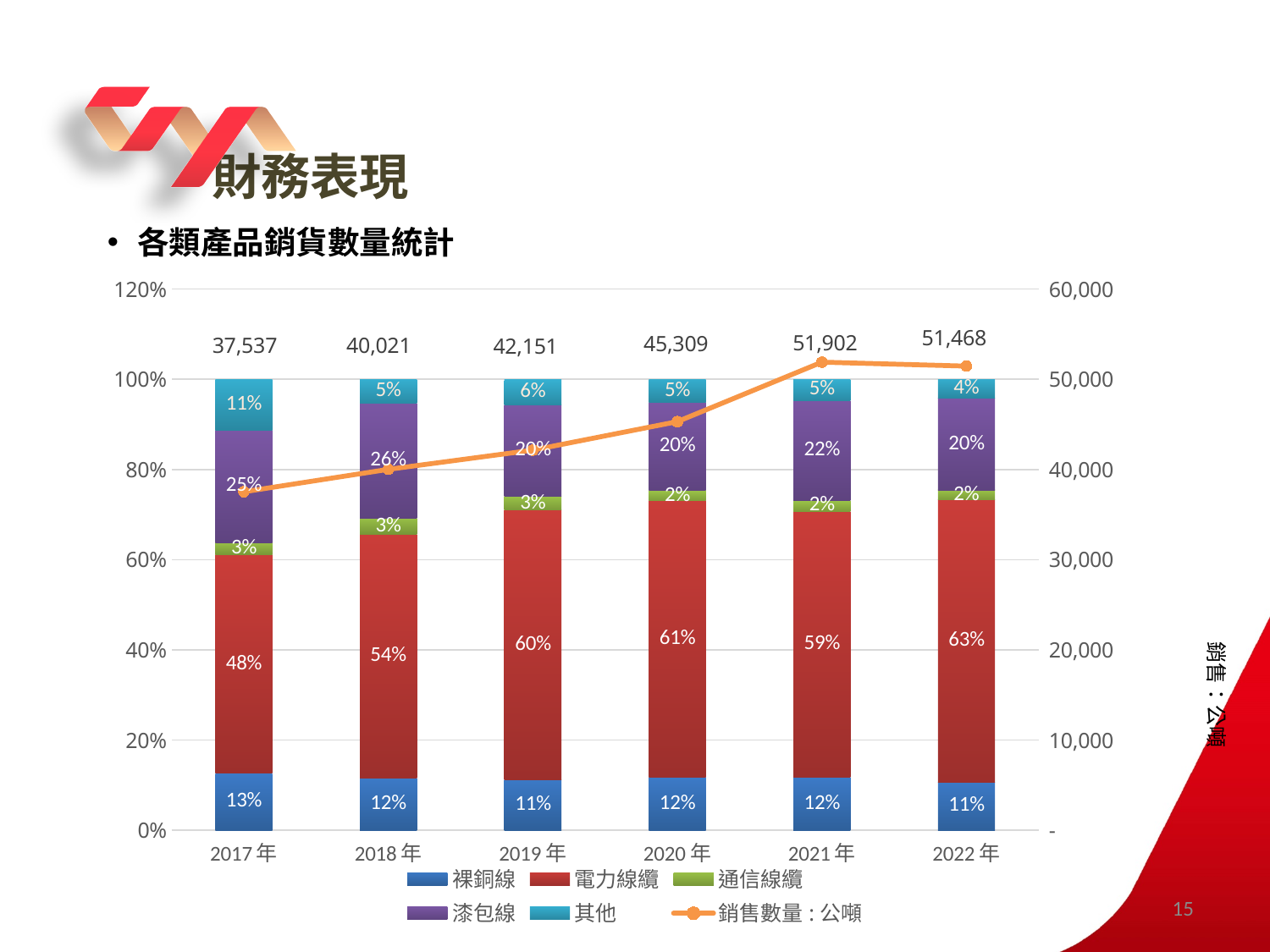
What is the 銷售數量 : 公噸 value for 2021 年? 51,902 What is the difference between the 銷售數量 : 公噸 values for 2021 年 and 2017 年? 14,365 Which is larger, the 漆包線 share in 2018 年 or in 2022 年? 2018 年 What percentage does 其他 account for in 2019 年? 6% What kind of chart is this? Stacked bar chart with a line Which year has the highest 銷售數量 : 公噸 value? 2021 年 Which year has the lowest 銷售數量 : 公噸 value? 2017 年 What percentage does 裸銅線 account for in 2017 年? 13% Is the 銷售數量 : 公噸 value for 2019 年 greater or less than 40,000? greater How many series does the legend list? 6 What percentage does 電力線纜 account for in 2022 年? 63% How many years are shown on the x axis? 6